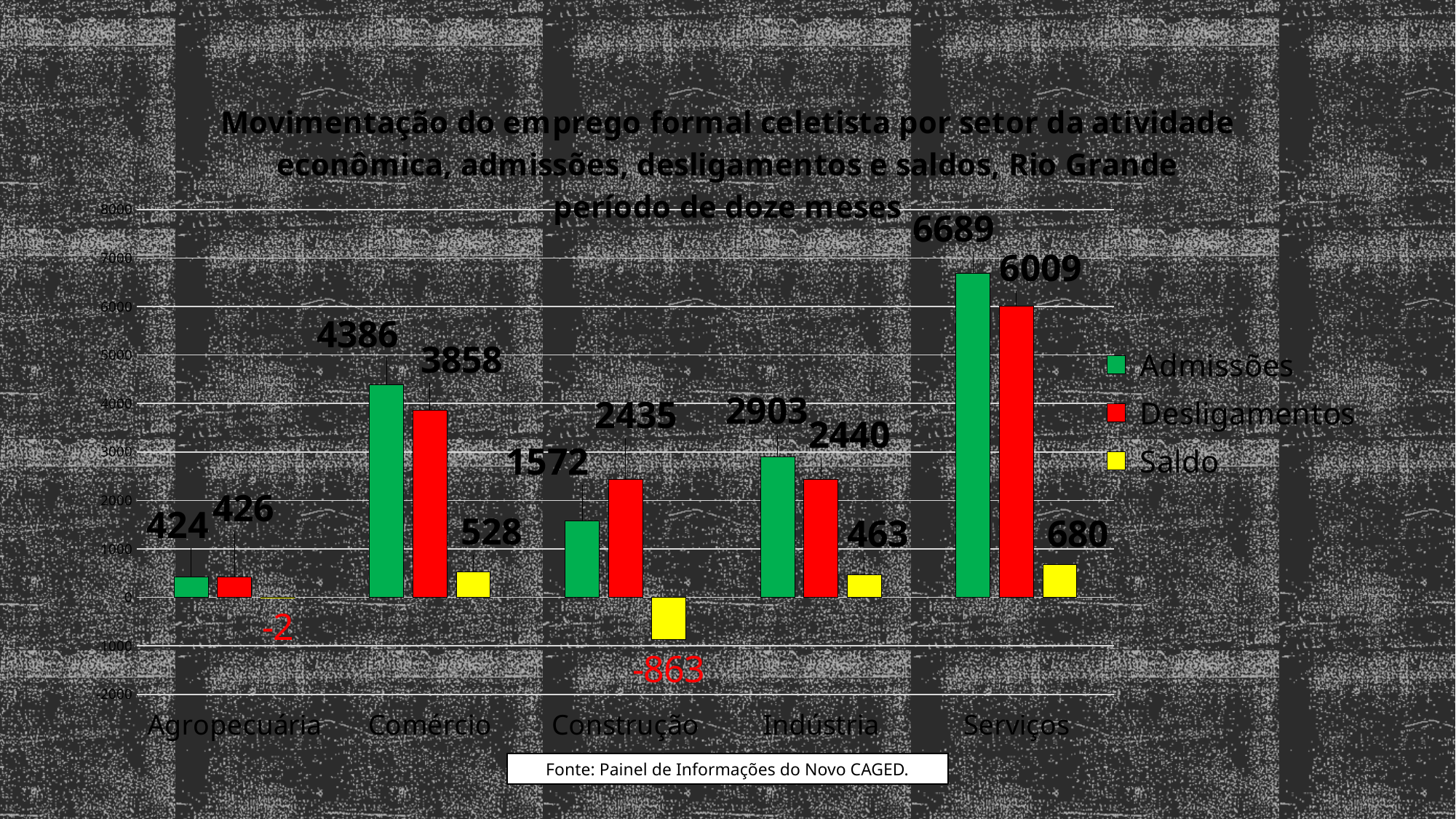
What is the Saldo value for Construção? -863 How many sectors are shown on the x axis? 5 Which sector has the lowest Desligamentos value? Agropecuária Which colour represents the Saldo series in the legend? Yellow What is the Saldo value for Agropecuária? -2 What is the value of Desligamentos for Serviços? 6009 What is the difference between Admissões and Desligamentos for Indústria? 463 What is the value of Admissões for Comércio? 4386 Which is larger for Construção: Admissões or Desligamentos? Desligamentos How many series does the legend list? 3 Which sector has the highest Admissões value? Serviços What kind of chart is shown on the slide? Bar chart